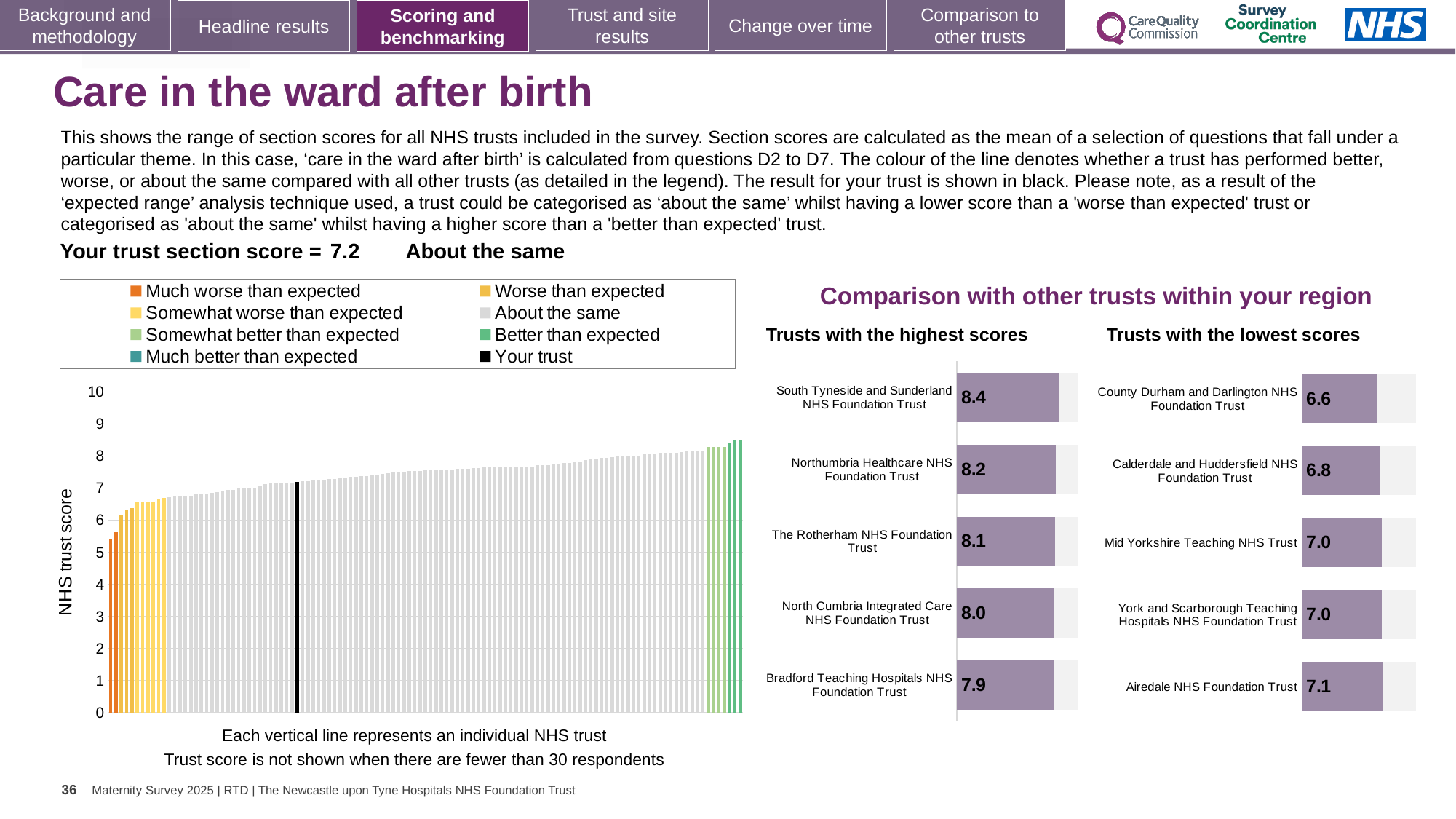
In the large 'NHS trust score' chart on the left, do the values rise or fall from left to right? rise What kind of chart is the large 'NHS trust score' chart on the left? bar chart In the 'Trusts with the lowest scores' chart, which trust has the lowest score? County Durham and Darlington NHS Foundation Trust In the 'Trusts with the lowest scores' chart, what is the score for County Durham and Darlington NHS Foundation Trust? 6.6 How many trusts are shown in the 'Trusts with the lowest scores' chart? 5 How many entries does the legend above the large 'NHS trust score' chart list? 8 In the 'Trusts with the lowest scores' chart, which has the higher score: Calderdale and Huddersfield NHS Foundation Trust or County Durham and Darlington NHS Foundation Trust? Calderdale and Huddersfield NHS Foundation Trust In the 'Trusts with the highest scores' chart, what is the difference between the scores of South Tyneside and Sunderland NHS Foundation Trust and Bradford Teaching Hospitals NHS Foundation Trust? 0.5 In the 'Trusts with the lowest scores' chart, what is the difference between the scores of Airedale NHS Foundation Trust and County Durham and Darlington NHS Foundation Trust? 0.5 In the 'Trusts with the highest scores' chart, what is the score for South Tyneside and Sunderland NHS Foundation Trust? 8.4 In the 'Trusts with the highest scores' chart, which trust has the highest score? South Tyneside and Sunderland NHS Foundation Trust In the 'Trusts with the highest scores' chart, what is the score for Bradford Teaching Hospitals NHS Foundation Trust? 7.9